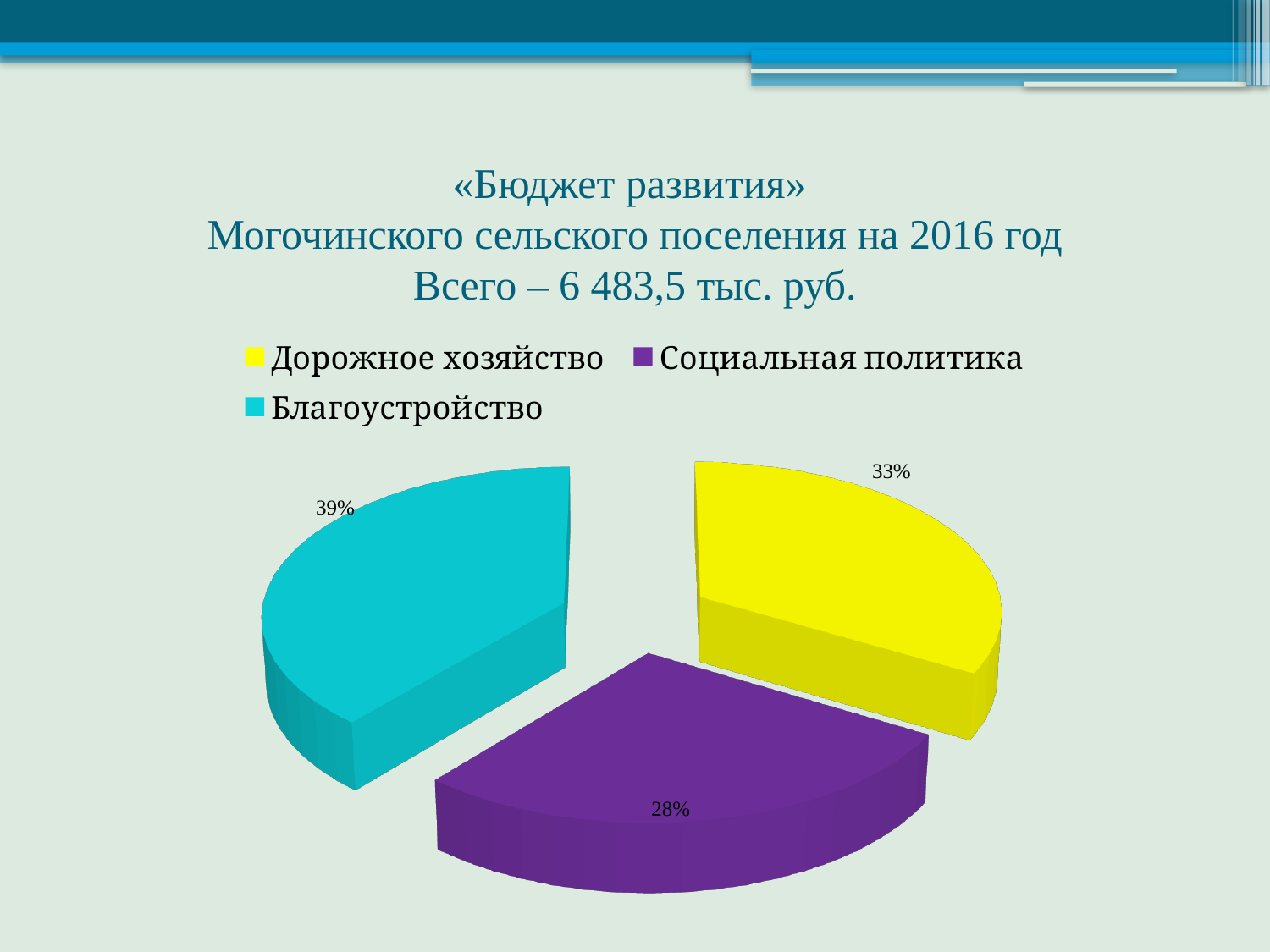
What is the difference in percentage points between Благоустройство and Социальная политика? 11 Which category has the smallest share of the pie? Социальная политика What share of the pie does Дорожное хозяйство have? 33% What is the difference in percentage points between Дорожное хозяйство and Социальная политика? 5 What kind of chart is shown on the slide? Pie chart How many slices does the pie chart have? 3 Which has a larger share, Дорожное хозяйство or Благоустройство? Благоустройство Which category has the largest share of the pie? Благоустройство What total amount is stated in the chart title? 6 483,5 тыс. руб. What share of the pie does Социальная политика have? 28% Which colour represents Социальная политика in the legend? Purple What share of the pie does Благоустройство have? 39%